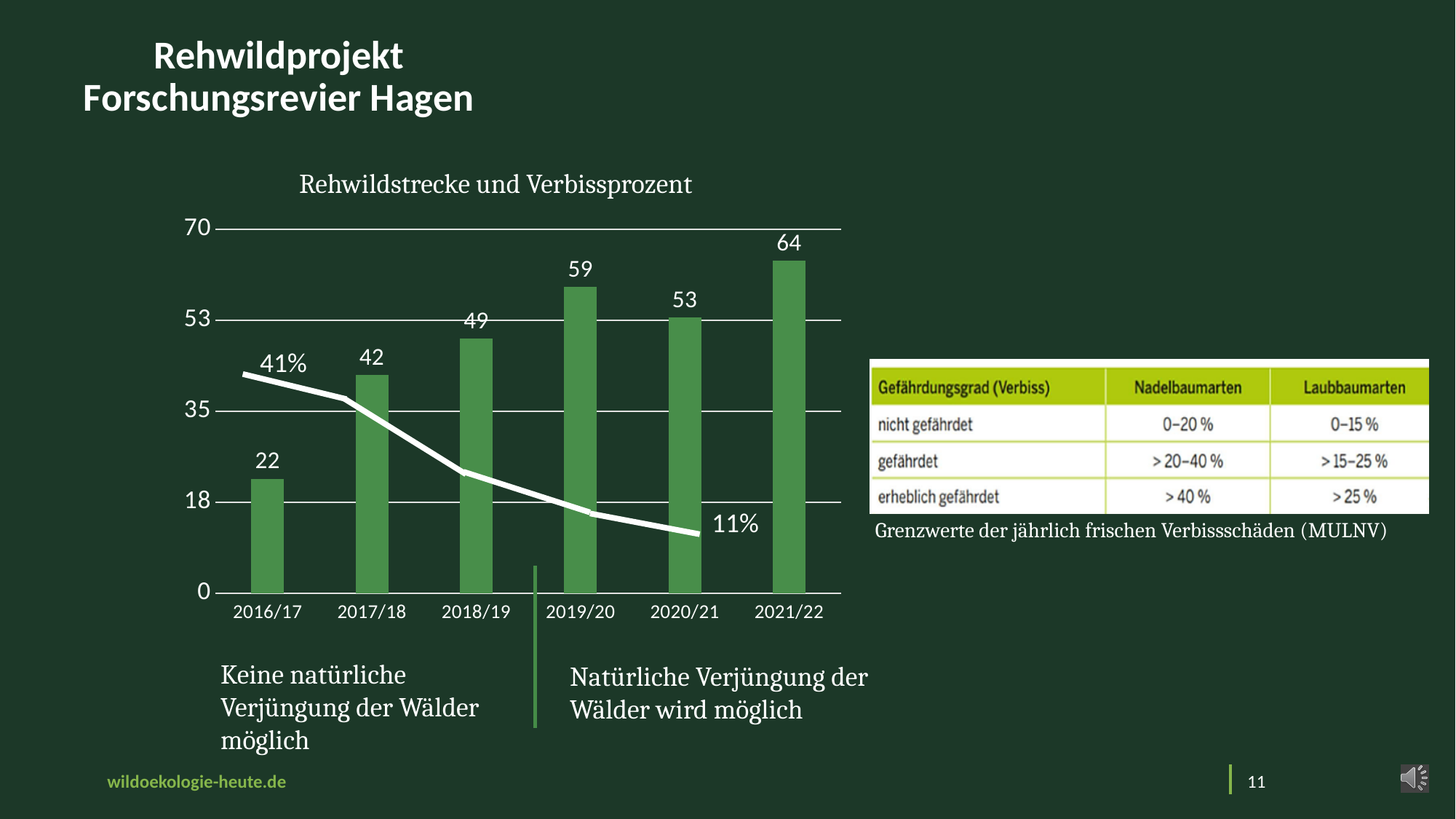
Which bar is taller, 2019/20 or 2020/21? 2019/20 Does the white line rise or fall from 2016/17 to 2020/21? fall What percentage is labelled at the start of the line in 2016/17? 41% How many bars are shown in the chart? 6 Which year has the lowest bar? 2016/17 What is the bar value for 2016/17? 22 Which year has the highest bar? 2021/22 What is the title of the chart? Rehwildstrecke und Verbissprozent What is the bar value for 2019/20? 59 What is the bar value for 2021/22? 64 What percentage is labelled at the end of the line? 11% What is the difference between the bar values for 2021/22 and 2016/17? 42